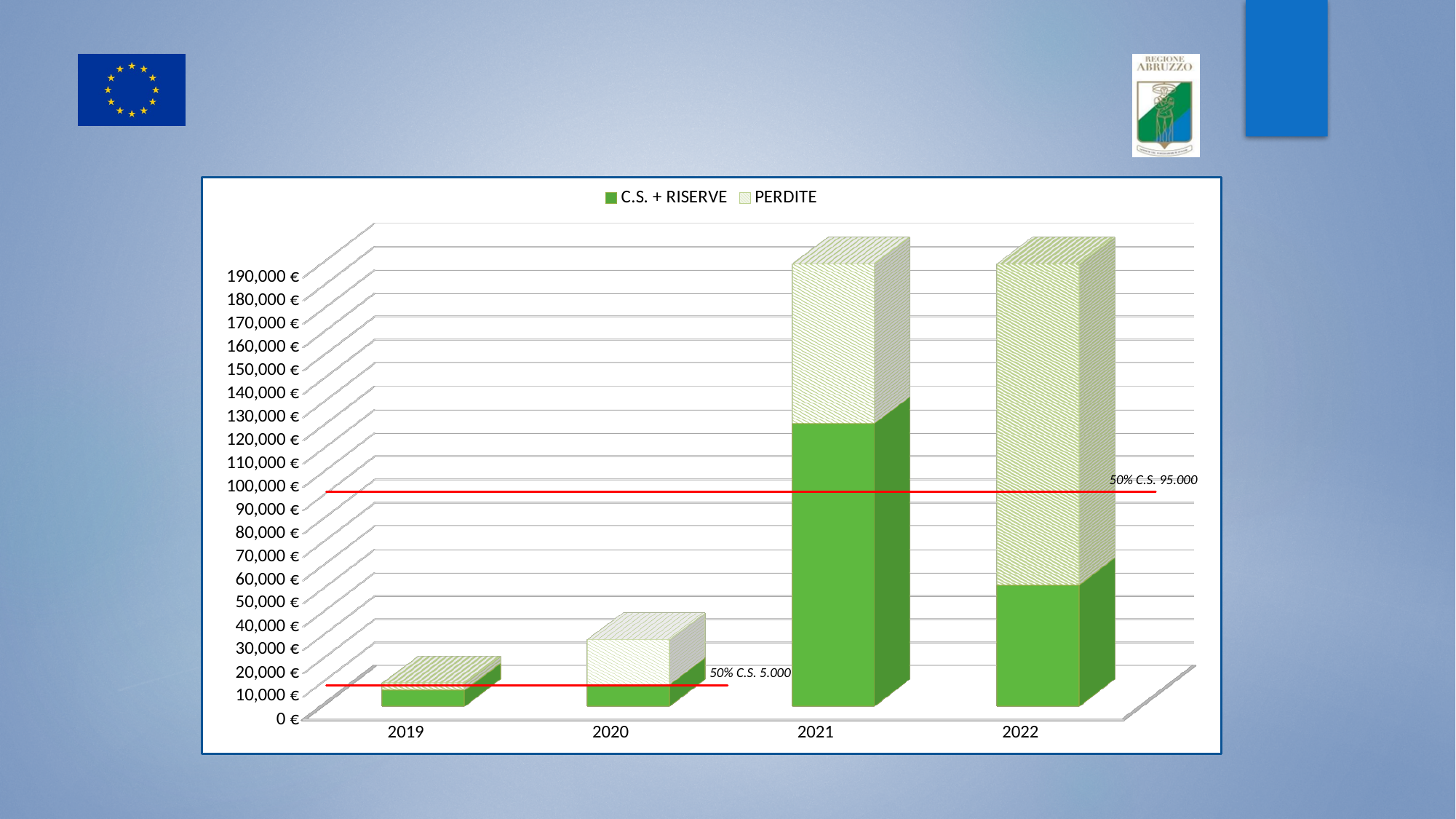
What label is written next to the upper red line on the chart? 50% C.S. 95.000 How many series does the chart legend list? 2 Which year has the larger PERDITE segment, 2021 or 2022? 2022 Is the total bar for 2019 greater or less than 50,000 €? less Which year has the lowest total bar in the chart? 2019 Which series are listed in the chart legend? C.S. + RISERVE and PERDITE Is the total bar for 2021 greater or less than 100,000 €? greater What kind of chart is shown on the slide? Stacked bar chart How many years are shown on the x axis of the chart? 4 Is the C.S. + RISERVE value for 2021 greater or less than 100,000 €? greater Which year has the larger total bar, 2019 or 2020? 2020 Which year has the largest C.S. + RISERVE segment? 2021